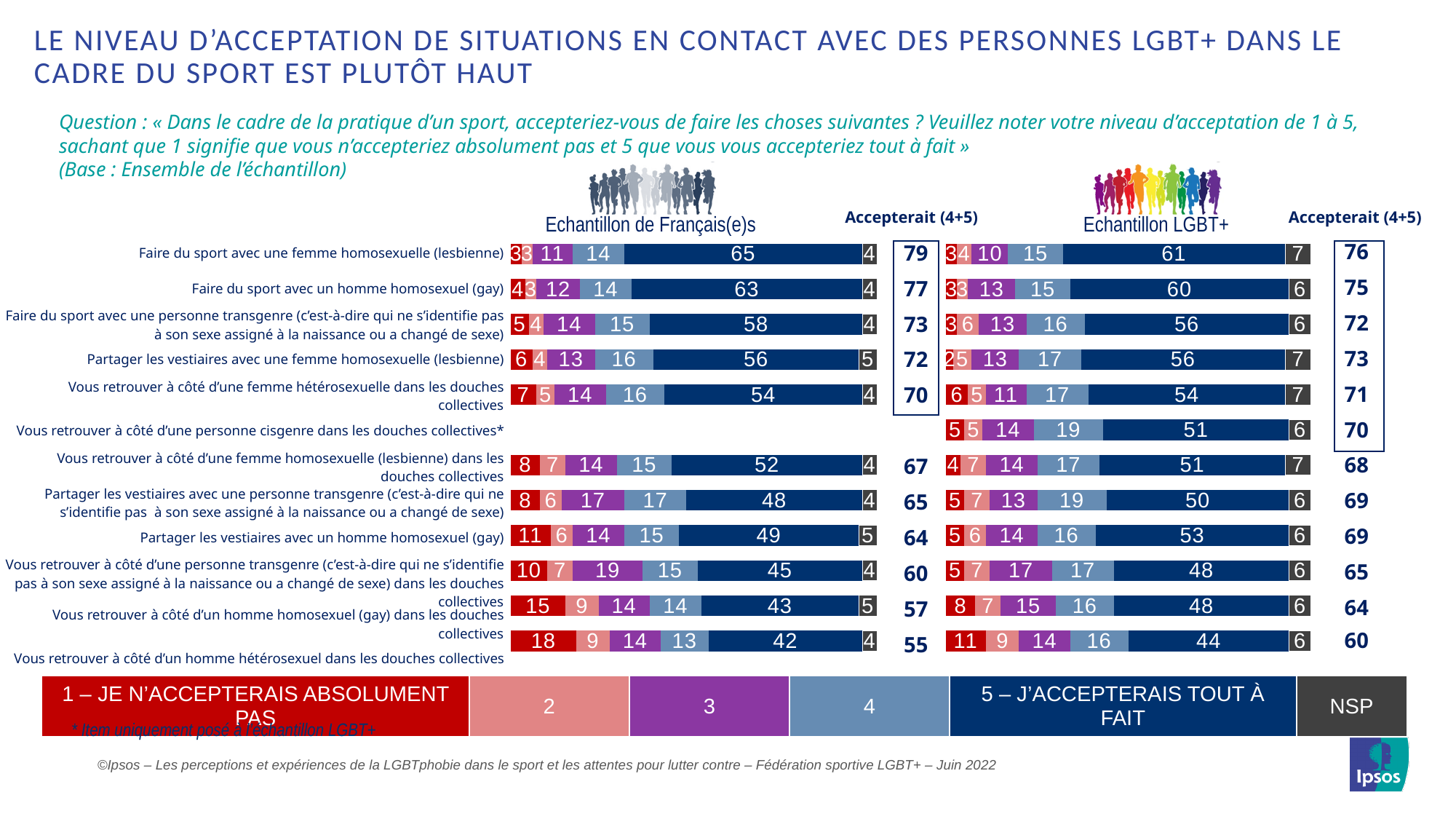
What type of chart is used to show the 'Echantillon de Français(e)s' results? Stacked bar chart In the 'Echantillon de Français(e)s' chart, what percentage chose '1 – Je n'accepterais absolument pas' for 'Vous retrouver à côté d'un homme hétérosexuel dans les douches collectives'? 18 In the 'Echantillon LGBT+' chart, which item has the lowest 'Accepterait (4+5)' value? Vous retrouver à côté d'un homme hétérosexuel dans les douches collectives For 'Partager les vestiaires avec un homme homosexuel (gay)', which chart shows the higher 'Accepterait (4+5)' value: 'Echantillon de Français(e)s' or 'Echantillon LGBT+'? Echantillon LGBT+ How many response categories does the legend at the bottom of the slide list? 6 How many items (rows) are plotted in the 'Echantillon LGBT+' chart? 12 In the 'Echantillon de Français(e)s' chart, what percentage chose '5 – J'accepterais tout à fait' for 'Faire du sport avec une femme homosexuelle (lesbienne)'? 65 In the 'Echantillon de Français(e)s' chart, what is the NSP value for 'Partager les vestiaires avec une femme homosexuelle (lesbienne)'? 5 In the 'Echantillon LGBT+' chart, what percentage chose '5 – J'accepterais tout à fait' for 'Partager les vestiaires avec un homme homosexuel (gay)'? 53 What is the difference between the 'Accepterait (4+5)' values for 'Faire du sport avec un homme homosexuel (gay)' in the 'Echantillon de Français(e)s' chart and the 'Echantillon LGBT+' chart? 2 In the 'Echantillon LGBT+' chart, what is the 'Accepterait (4+5)' value for 'Vous retrouver à côté d'une personne cisgenre dans les douches collectives'? 70 In the 'Echantillon de Français(e)s' chart, which item has the highest 'Accepterait (4+5)' value? Faire du sport avec une femme homosexuelle (lesbienne)